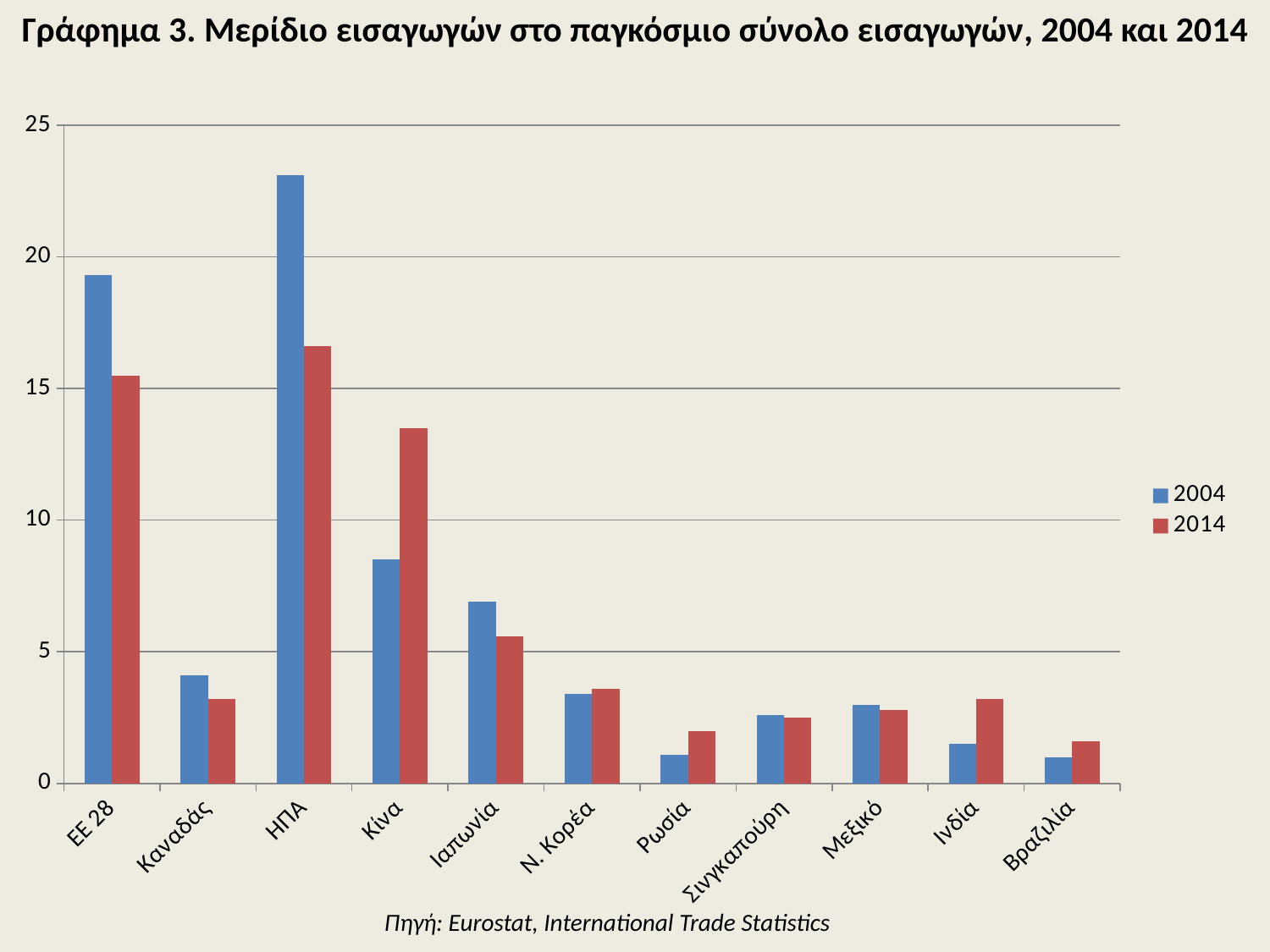
For ΕΕ 28, which year has the larger value, 2004 or 2014? 2004 What kind of chart is shown on the slide? bar chart How many series does the legend list? 2 How many countries/regions are shown on the x axis? 11 Which category has the highest value for 2014? ΗΠΑ Is the 2014 value for ΕΕ 28 greater or less than 15? greater Which category has the highest value for 2004? ΗΠΑ Is the 2004 value for Κίνα greater or less than 10? less For Κίνα, which year has the larger value, 2004 or 2014? 2014 Is the 2004 value for ΗΠΑ greater or less than 20? greater What source is cited below the chart? Eurostat, International Trade Statistics